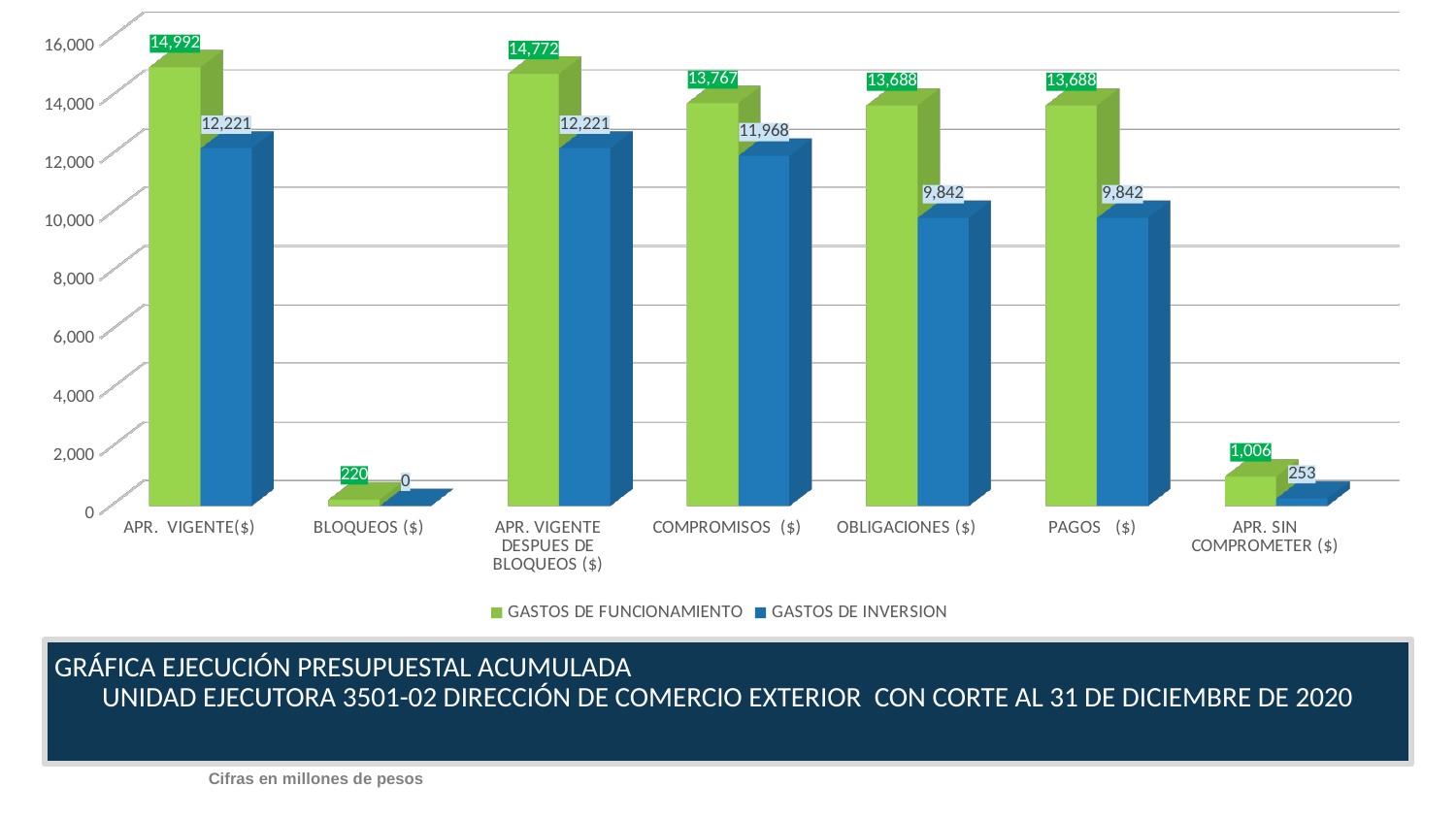
Which is larger for PAGOS ($): GASTOS DE FUNCIONAMIENTO or GASTOS DE INVERSION? GASTOS DE FUNCIONAMIENTO What is the difference between GASTOS DE FUNCIONAMIENTO and GASTOS DE INVERSION for OBLIGACIONES ($)? 3,846 What is the difference between GASTOS DE FUNCIONAMIENTO for APR. VIGENTE($) and for APR. VIGENTE DESPUES DE BLOQUEOS ($)? 220 How many categories are shown on the x axis? 7 What is the value of GASTOS DE FUNCIONAMIENTO for APR. VIGENTE($)? 14,992 What kind of chart is shown on the slide? Bar chart What is the value of GASTOS DE INVERSION for BLOQUEOS ($)? 0 How many series does the legend list? 2 What is the value of GASTOS DE FUNCIONAMIENTO for APR. SIN COMPROMETER ($)? 1,006 What is the value of GASTOS DE INVERSION for COMPROMISOS ($)? 11,968 Which category has the lowest GASTOS DE INVERSION value? BLOQUEOS ($) Which category has the highest GASTOS DE FUNCIONAMIENTO value? APR. VIGENTE($)